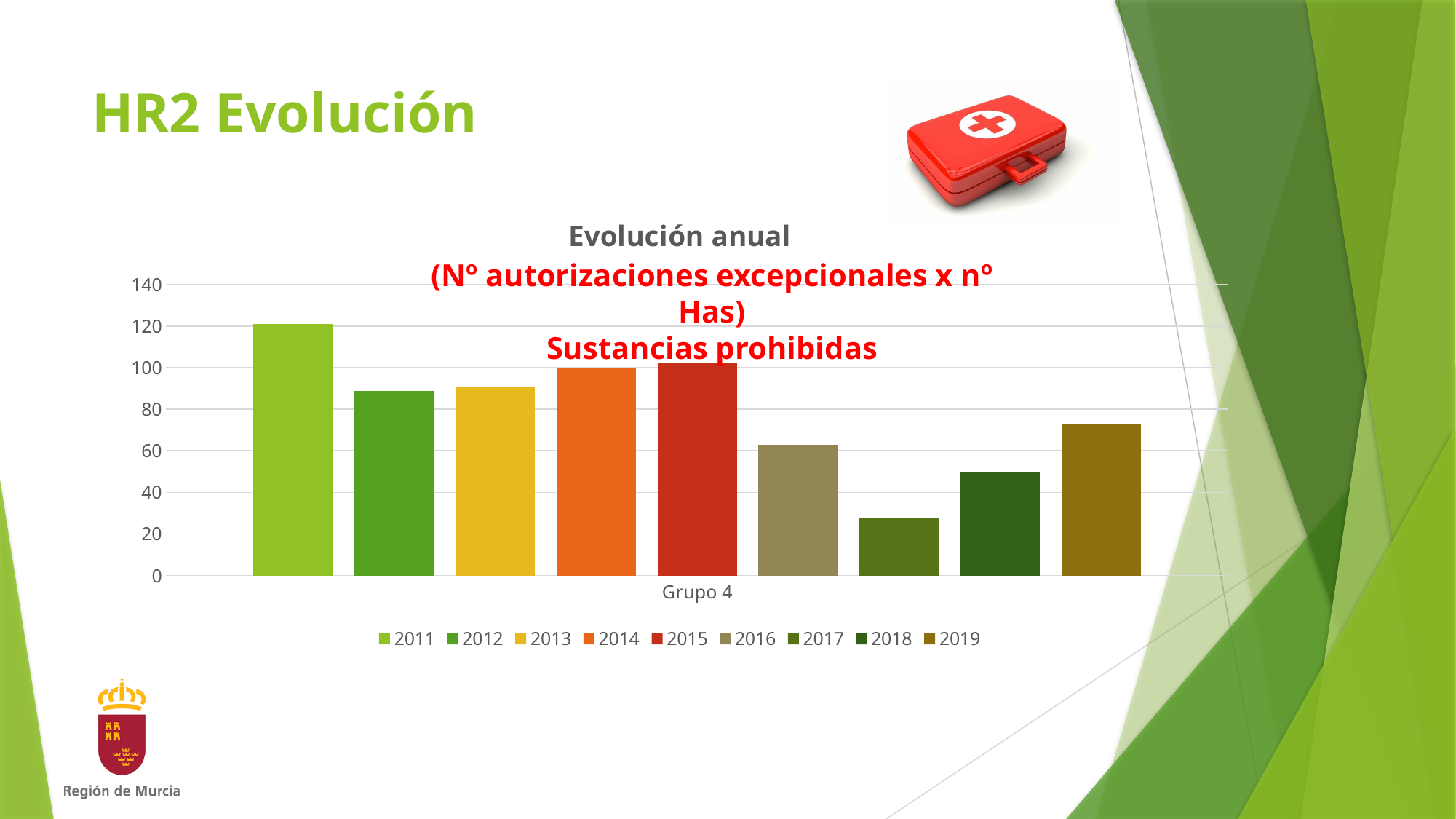
What kind of chart is shown on the slide? bar chart How many categories are shown on the x axis? 1 What is the first line of the chart title? Evolución anual Which year has the highest bar? 2011 Is the value for 2019 greater or less than 60? greater Which year has the lowest bar? 2017 Is the value for 2017 greater or less than 40? less How many series does the legend list? 9 Which is larger, the value for 2011 or the value for 2019? 2011 Is the value for 2011 greater or less than 100? greater Which is larger, the value for 2016 or the value for 2018? 2016 What is the category label shown on the x axis? Grupo 4